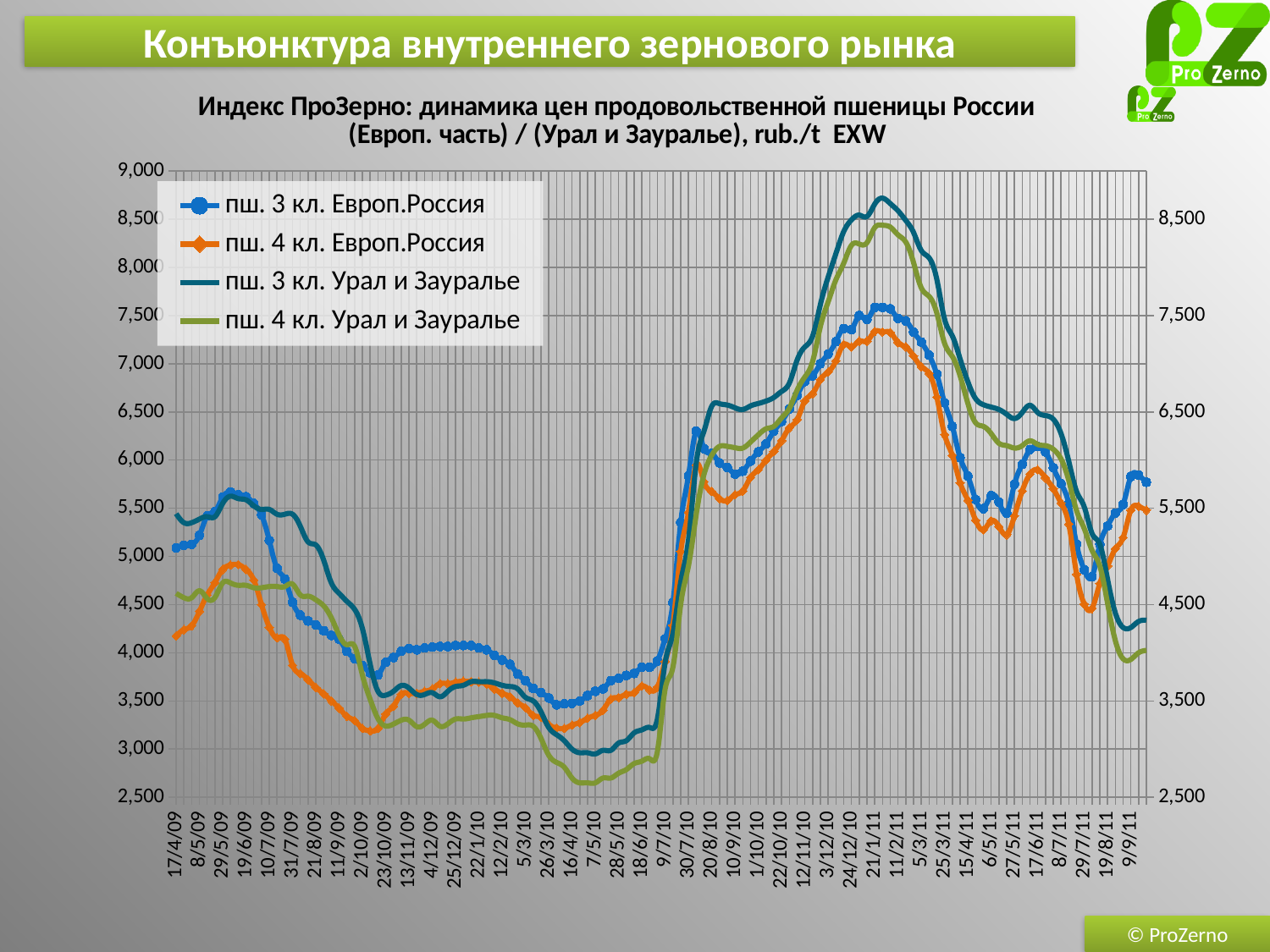
What kind of chart is shown on the slide? line chart How many series does the legend list? 4 At the last date on the chart (9/9/11), which is higher: пш. 3 кл. Европ.Россия or пш. 3 кл. Урал и Зауралье? пш. 3 кл. Европ.Россия Which series falls to the lowest value on the chart? пш. 4 кл. Урал и Зауралье Between 9/7/10 and 21/1/11, do the prices rise or fall? rise Is the value for пш. 4 кл. Европ.Россия at 17/4/09 greater or less than 4,500? less Which series is drawn in orange? пш. 4 кл. Европ.Россия Is the lowest value of пш. 4 кл. Урал и Зауралье around 16/4/10 greater or less than 3,000? less Which series reaches the highest value on the chart? пш. 3 кл. Урал и Зауралье Is the value for пш. 3 кл. Урал и Зауралье at 17/4/09 greater or less than 5,000? greater Around 21/1/11, which is higher: пш. 3 кл. Урал и Зауралье or пш. 3 кл. Европ.Россия? пш. 3 кл. Урал и Зауралье